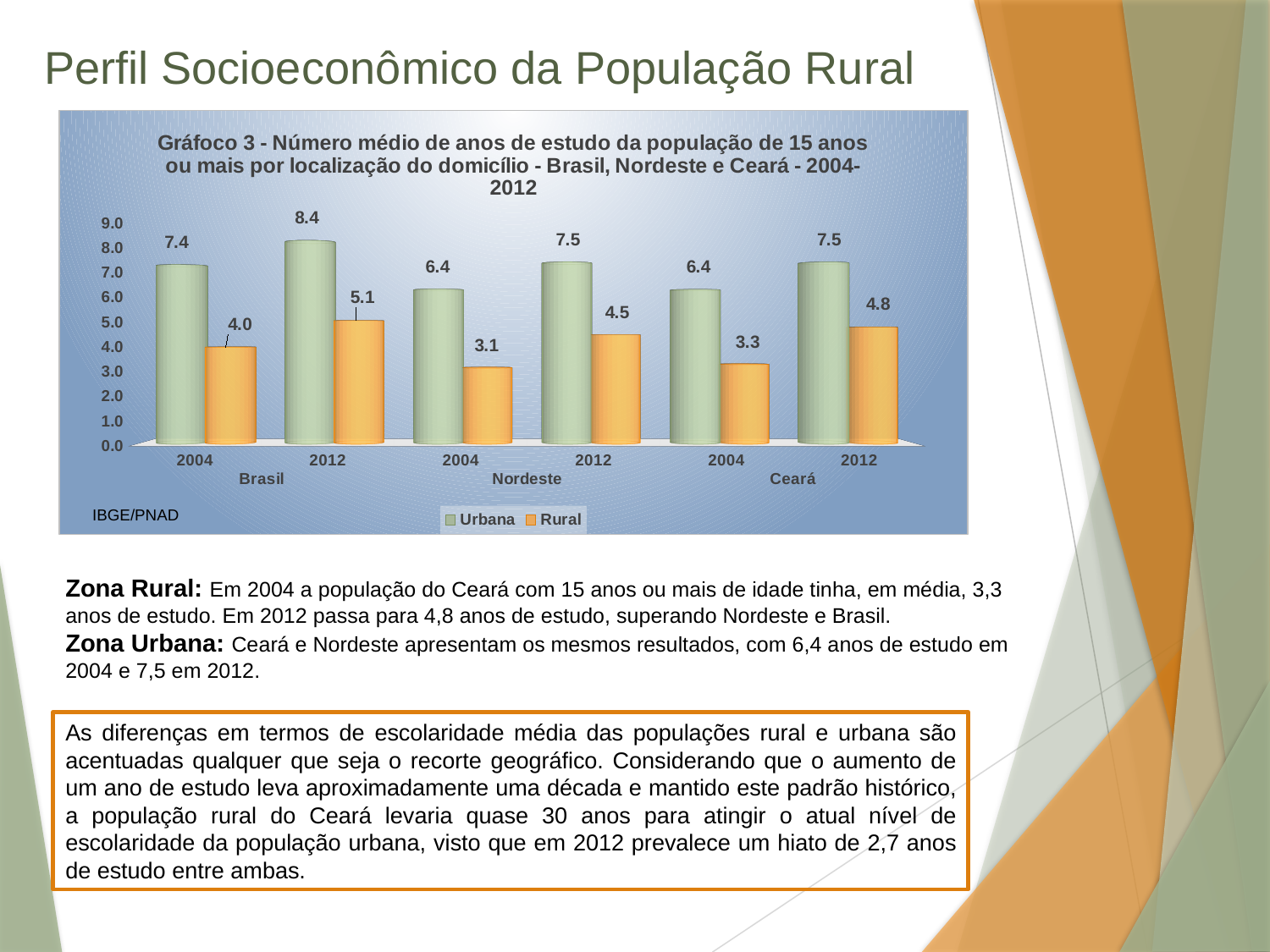
How many series does the legend list? 2 What is the Urbana value for Brasil in 2012? 8.4 What kind of chart is shown? Bar chart What is the difference between the Urbana and Rural values for Ceará in 2012? 2.7 Does the Rural value for Nordeste rise or fall from 2004 to 2012? Rise Which is larger, the Rural value for Brasil in 2004 or the Rural value for Ceará in 2012? Ceará 2012 What is the Rural value for Ceará in 2004? 3.3 What is the Rural value for Nordeste in 2012? 4.5 Which category has the highest Urbana value? Brasil 2012 What is the difference between the Rural values for Brasil in 2012 and 2004? 1.1 What source is cited at the bottom left of the chart? IBGE/PNAD Which category has the lowest Rural value? Nordeste 2004